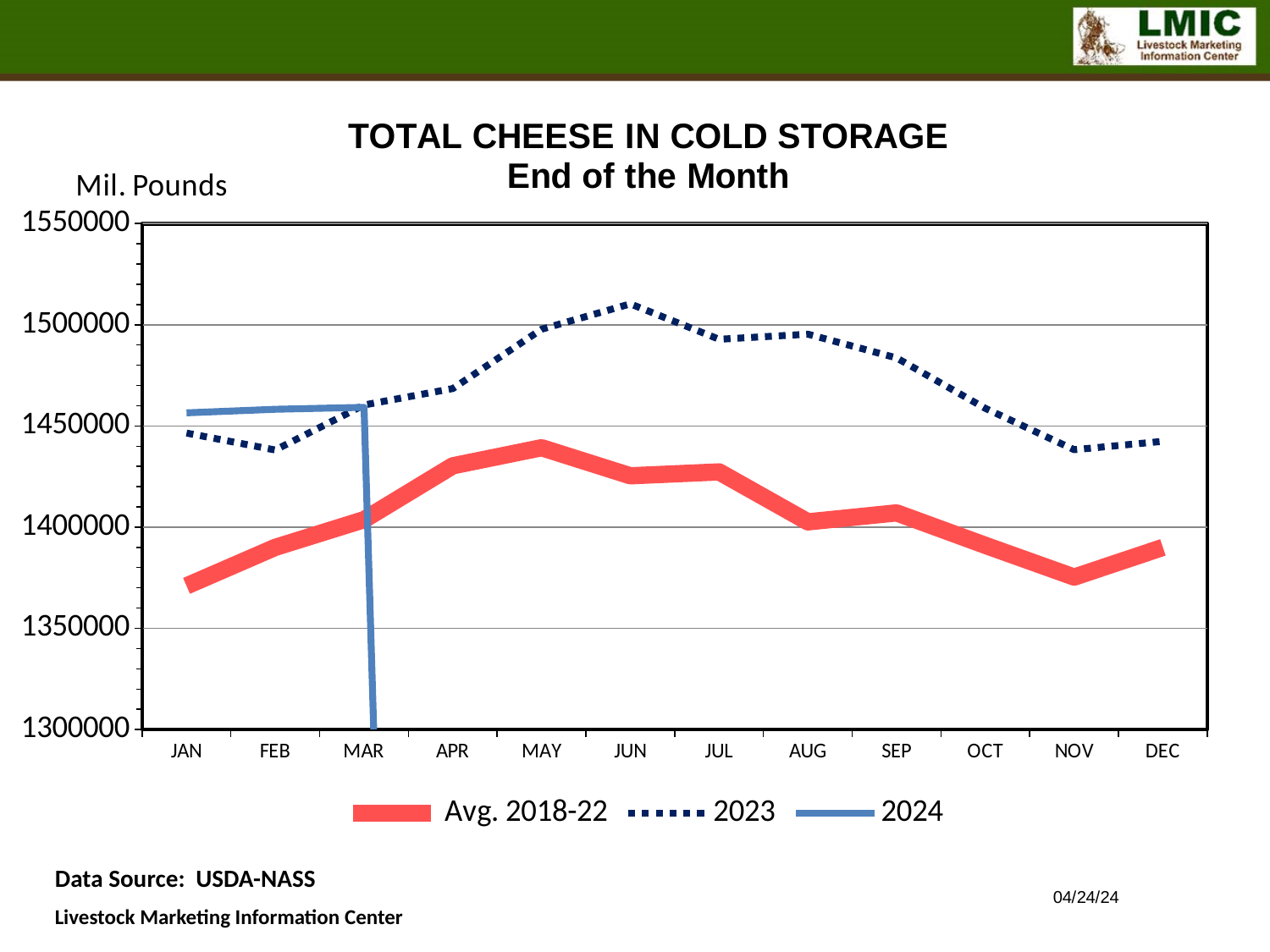
Is the 2023 value for JUN greater or less than 1500000? greater In which month does the 2023 series reach its highest value? JUN In JUN, which series has the larger value, 2023 or Avg. 2018-22? 2023 What unit is shown on the y axis label? Mil. Pounds How many months are shown along the x axis? 12 Is the Avg. 2018-22 value for JAN greater or less than 1400000? less In which month does the Avg. 2018-22 series reach its highest value? MAY What kind of chart is shown on the slide? line chart In which month does the Avg. 2018-22 series reach its lowest value? JAN Is the Avg. 2018-22 value for MAY greater or less than 1400000? greater Does the Avg. 2018-22 series rise or fall from JAN to MAY? rise How many series does the legend list? 3